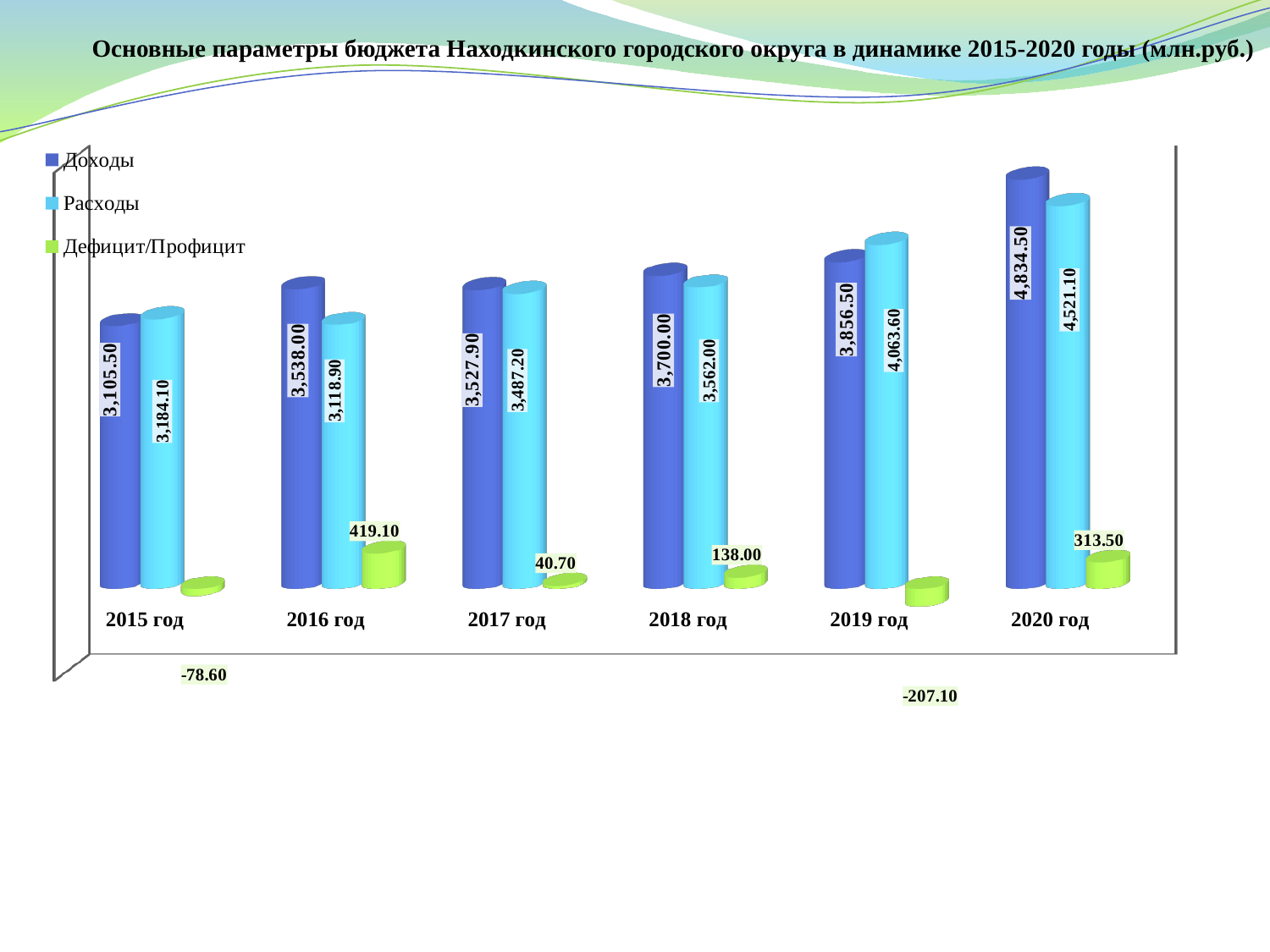
What is the value of Дефицит/Профицит for 2019 год? -207.10 How many years are shown on the x axis? 6 What is the value of Дефицит/Профицит for 2016 год? 419.10 Which is larger in 2018 год, Доходы or Расходы? Доходы What is the difference between Доходы and Расходы in 2020 год? 313.40 In which year is Расходы lowest? 2016 год What kind of chart is shown on the slide? Bar chart What is the value of Расходы for 2019 год? 4,063.60 Do the Доходы values rise or fall from 2015 год to 2020 год? Rise How many series does the legend list? 3 What is the value of Доходы for 2015 год? 3,105.50 In which year is Доходы highest? 2020 год